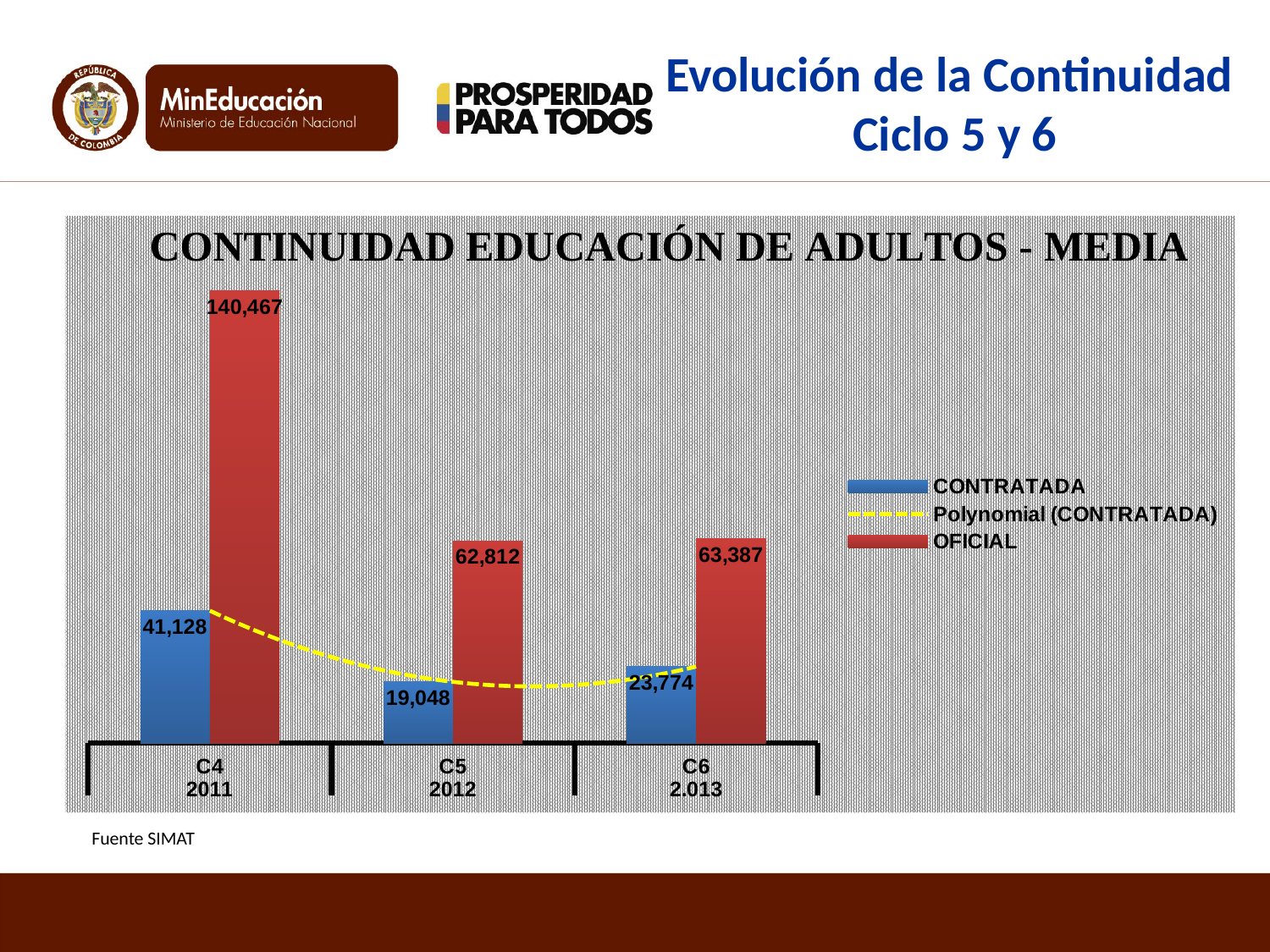
How many categories are shown on the x axis? 3 How many entries does the legend list? 3 Which is larger, the CONTRATADA value for C6 2.013 or the CONTRATADA value for C5 2012? C6 2.013 What is the difference between the OFICIAL and CONTRATADA values for C4 2011? 99,339 What kind of chart is shown? Bar chart What is the title of the chart? CONTINUIDAD EDUCACIÓN DE ADULTOS - MEDIA Which category has the lowest CONTRATADA value? C5 2012 What is the CONTRATADA value for C5 2012? 19,048 Which category has the highest OFICIAL value? C4 2011 What is the OFICIAL value for C5 2012? 62,812 What is the CONTRATADA value for C4 2011? 41,128 What is the OFICIAL value for C6 2.013? 63,387